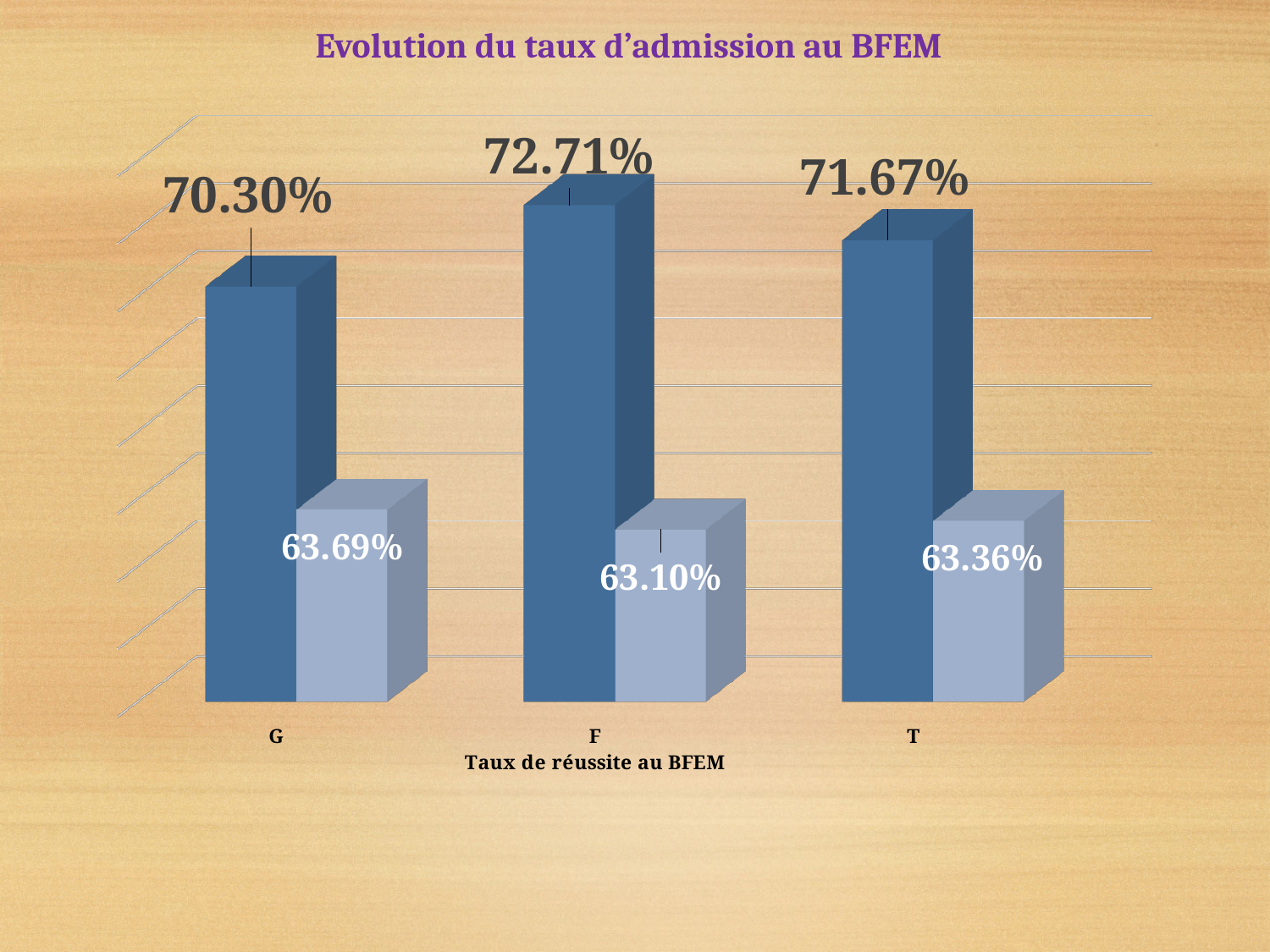
What is the value of the dark blue bar for category G? 70.30% Which is larger: the dark blue value for F or the dark blue value for T? F What is the value of the light blue bar for category T? 63.36% Which category has the lowest dark blue bar? G What is the value of the light blue bar for category F? 63.10% What is the difference between the dark blue and light blue values for category G? 6.61% How many categories are shown on the x axis? 3 What kind of chart is shown on the slide? Bar chart Which category has the highest dark blue bar? F What is the value of the dark blue bar for category T? 71.67% What is the difference between the dark blue values for F and G? 2.41% What is the title of the chart? Evolution du taux d'admission au BFEM